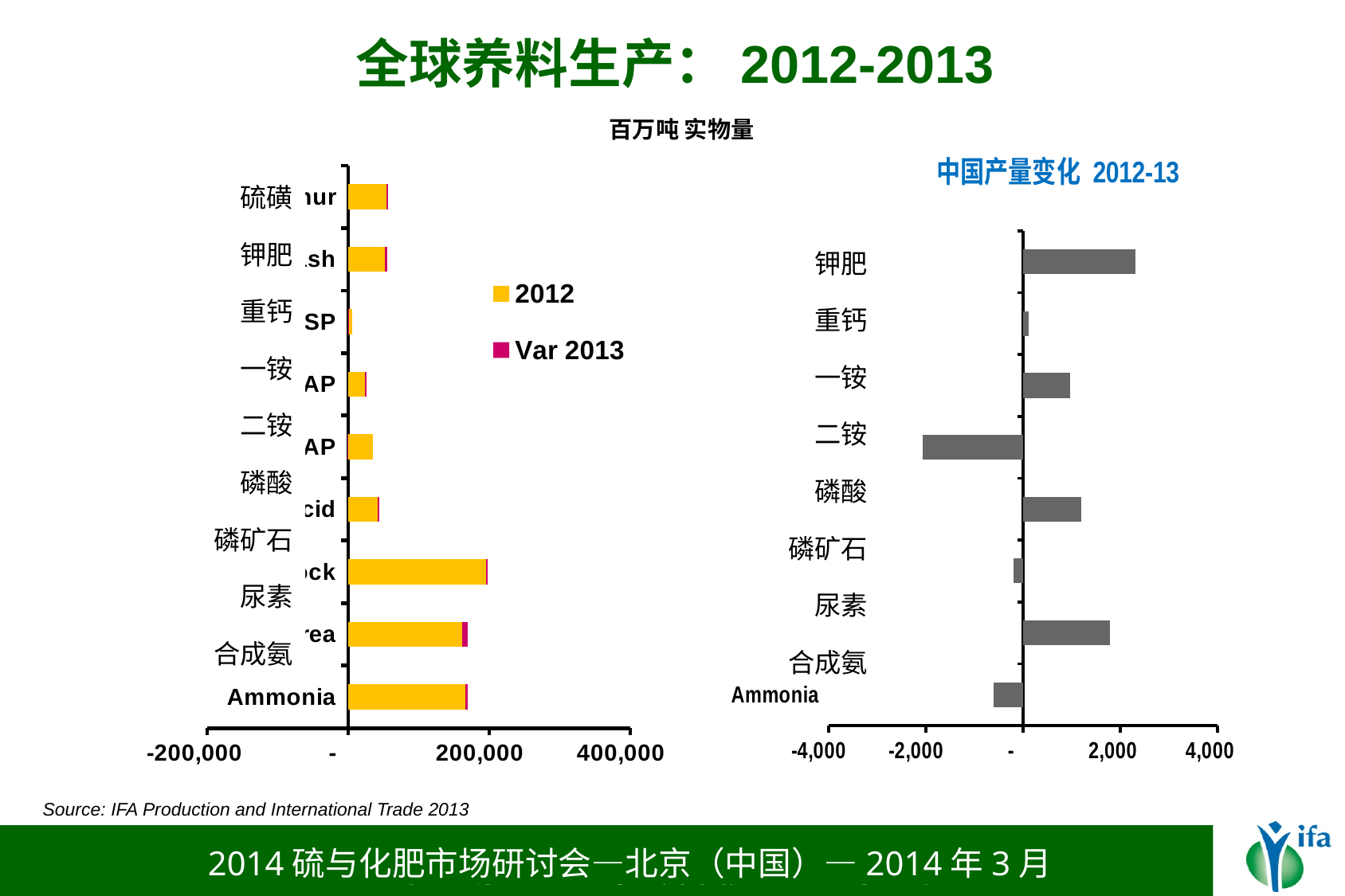
What are the two legend entries of the left chart? 2012 and Var 2013 In the left chart, is the 2012 value for Ammonia greater or less than 200,000? less How many series does the legend of the left chart list? 2 In the left chart, which category has the largest 2012 bar? 磷矿石 In the left chart, which category has the smallest 2012 bar? 重钙 What kind of chart is the left chart on the slide? bar chart What is the title of the right chart? 中国产量变化 2012-13 In the right chart (中国产量变化 2012-13), which category has the highest value? 钾肥 How many categories are shown on the right chart (中国产量变化 2012-13)? 8 In the right chart (中国产量变化 2012-13), which category has the lowest value? 二铵 How many categories are shown on the left chart? 9 In the left chart, which has a larger 2012 bar, 磷矿石 or Ammonia? 磷矿石